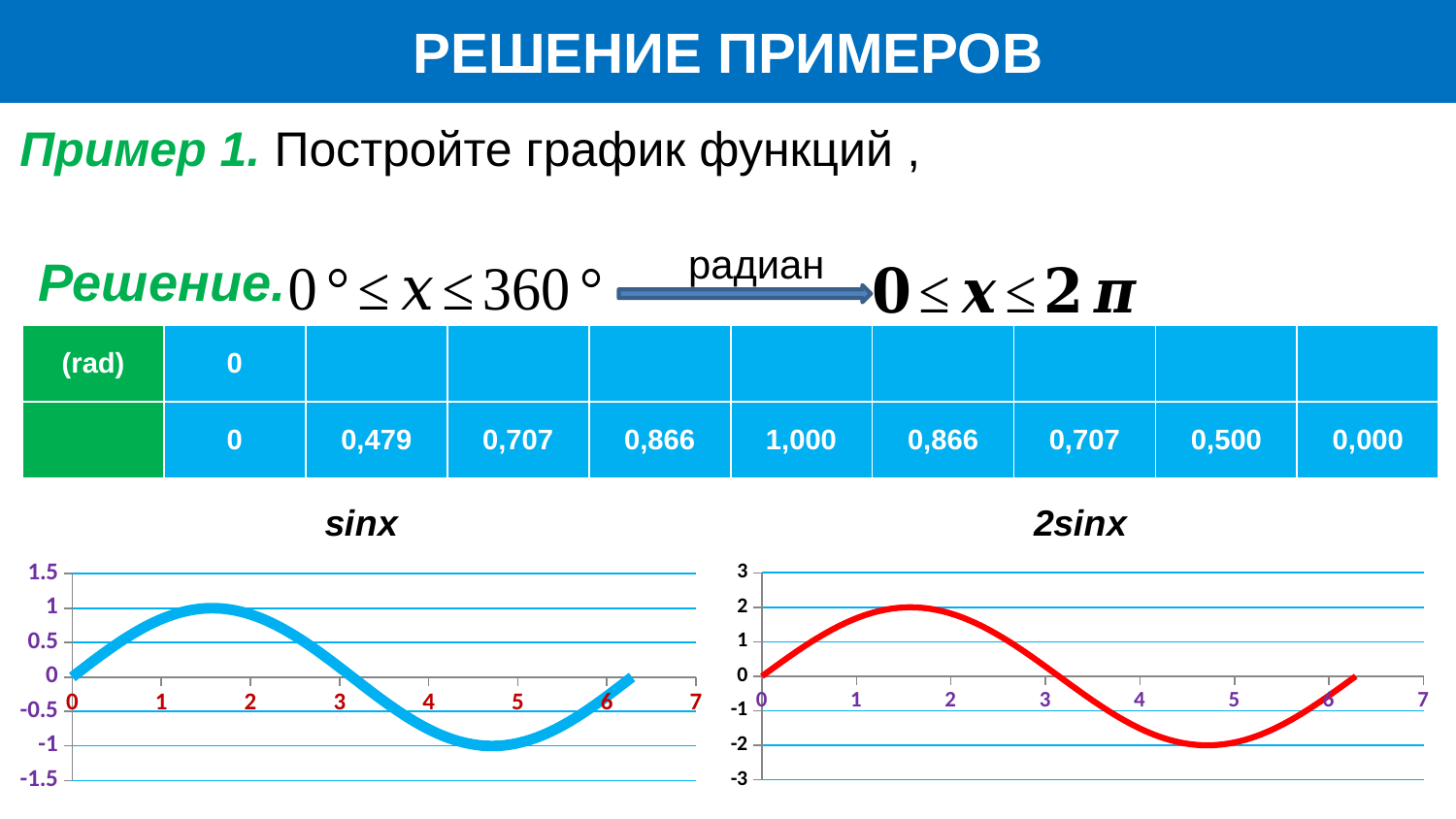
In the chart titled 2sinx, what is the highest value the line reaches? 2 Which chart reaches a higher peak value, sinx or 2sinx? 2sinx In the chart titled 2sinx, is the value at x = 5 greater or less than -1? less What kind of chart is the chart titled sinx? line chart What kind of chart is the chart titled 2sinx? line chart What is the title of the left chart? sinx In the chart titled 2sinx, does the line rise or fall between x = 2 and x = 4? fall In the chart titled sinx, is the value at x = 1 greater or less than 0.5? greater What colour is the line in the chart titled 2sinx? red In the chart titled 2sinx, what is the lowest value the line reaches? -2 In the chart titled sinx, what is the lowest value the line reaches? -1 In the chart titled sinx, what is the highest value the line reaches? 1